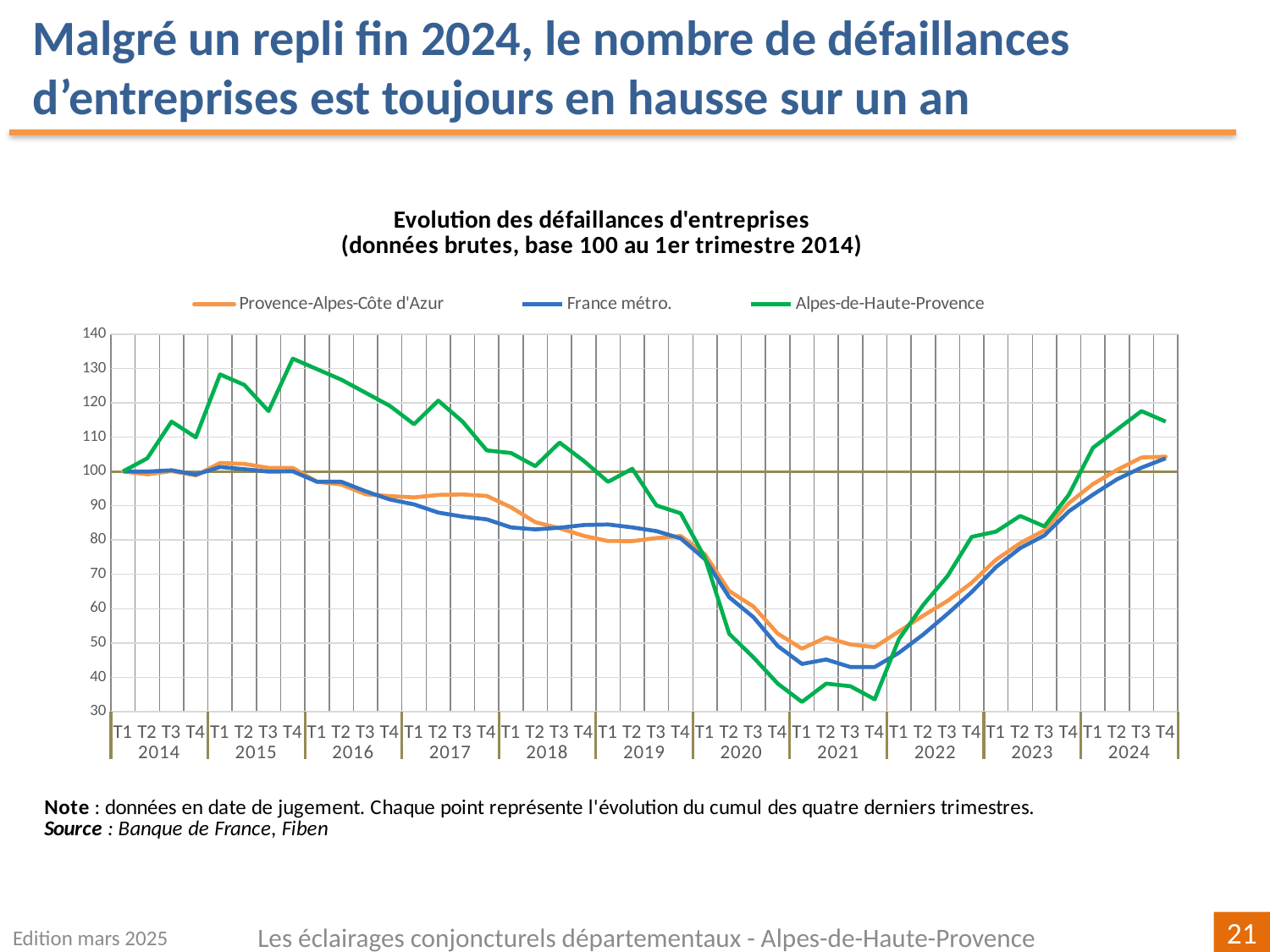
Does the Alpes-de-Haute-Provence series rise or fall between T4 2015 and T1 2021? fall In which quarter does the Alpes-de-Haute-Provence series reach its highest value? T4 2015 What is the value of each series at T1 2014, the base period? 100 Is the value for Alpes-de-Haute-Provence at T4 2015 greater or less than 130? greater Is the value for Alpes-de-Haute-Provence at T1 2021 greater or less than 40? less Is the value for France métro. at T1 2021 greater or less than 50? less What kind of chart is shown on the slide? line chart At T4 2024, which series is higher: Alpes-de-Haute-Provence or France métro.? Alpes-de-Haute-Provence How many years are labelled on the x axis? 11 How many series does the legend list? 3 Which series is drawn in green? Alpes-de-Haute-Provence